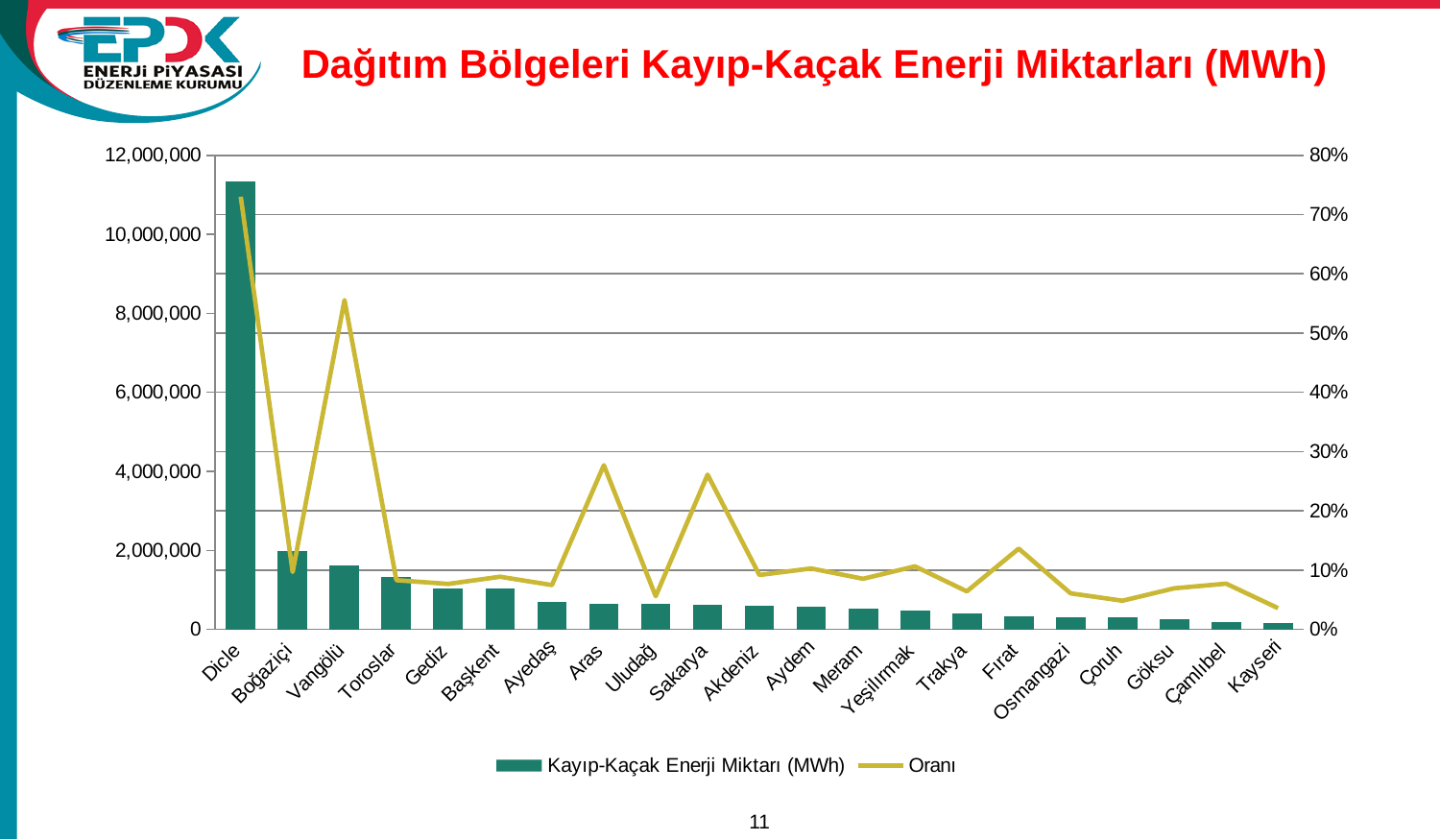
Which region has the higher Oranı value, Boğaziçi or Vangölü? Vangölü Is the Kayıp-Kaçak Enerji Miktarı (MWh) value for Dicle greater or less than 10,000,000? greater Which region has the highest Kayıp-Kaçak Enerji Miktarı (MWh) bar? Dicle How many distribution regions are shown on the x axis of the chart? 21 What is the title of the chart on the slide? Dağıtım Bölgeleri Kayıp-Kaçak Enerji Miktarları (MWh) Is the Kayıp-Kaçak Enerji Miktarı (MWh) value for Toroslar greater or less than 2,000,000? less Do the Kayıp-Kaçak Enerji Miktarı (MWh) bars generally rise or fall from left to right along the x axis? fall How many series does the chart legend list? 2 Which region has the lowest Kayıp-Kaçak Enerji Miktarı (MWh) bar? Kayseri Is the Oranı value for Uludağ greater or less than 10%? less What kind of chart is shown on the slide? Combined bar and line chart